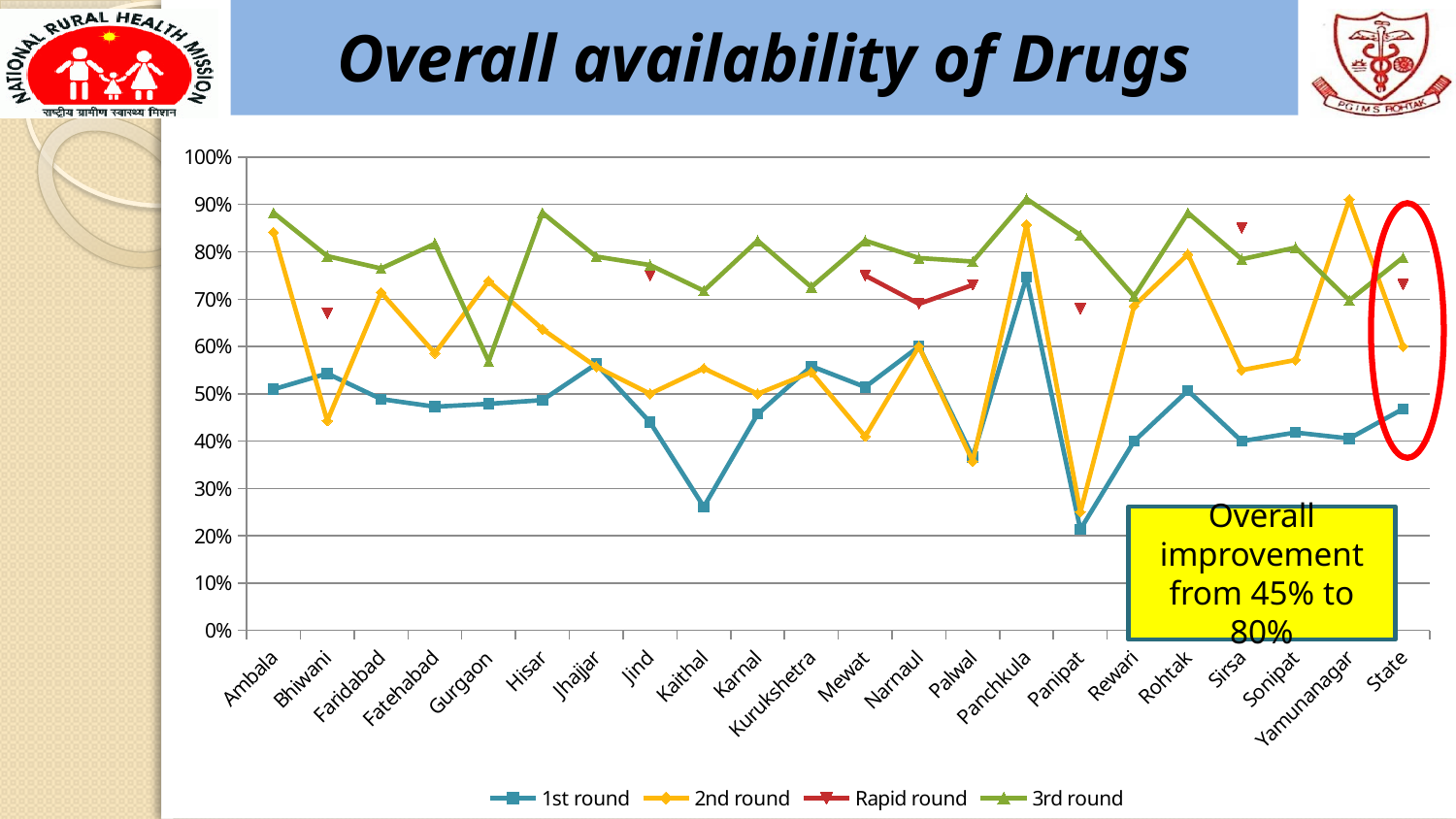
How many series does the legend list? 4 What kind of chart is shown on the slide? Line chart For which category is the 3rd round value highest? Panchkula Is the 1st round value for Kaithal greater or less than 30%? less Is the 1st round value for Panchkula greater or less than 70%? greater For which category is the 2nd round value lowest? Panipat Which series are listed in the legend? 1st round, 2nd round, Rapid round, 3rd round Is the 3rd round value for Gurgaon greater or less than 60%? less How many categories are shown along the x axis? 22 What is the title of the chart? Overall availability of Drugs At Ambala, which is larger: the 1st round value or the 2nd round value? 2nd round